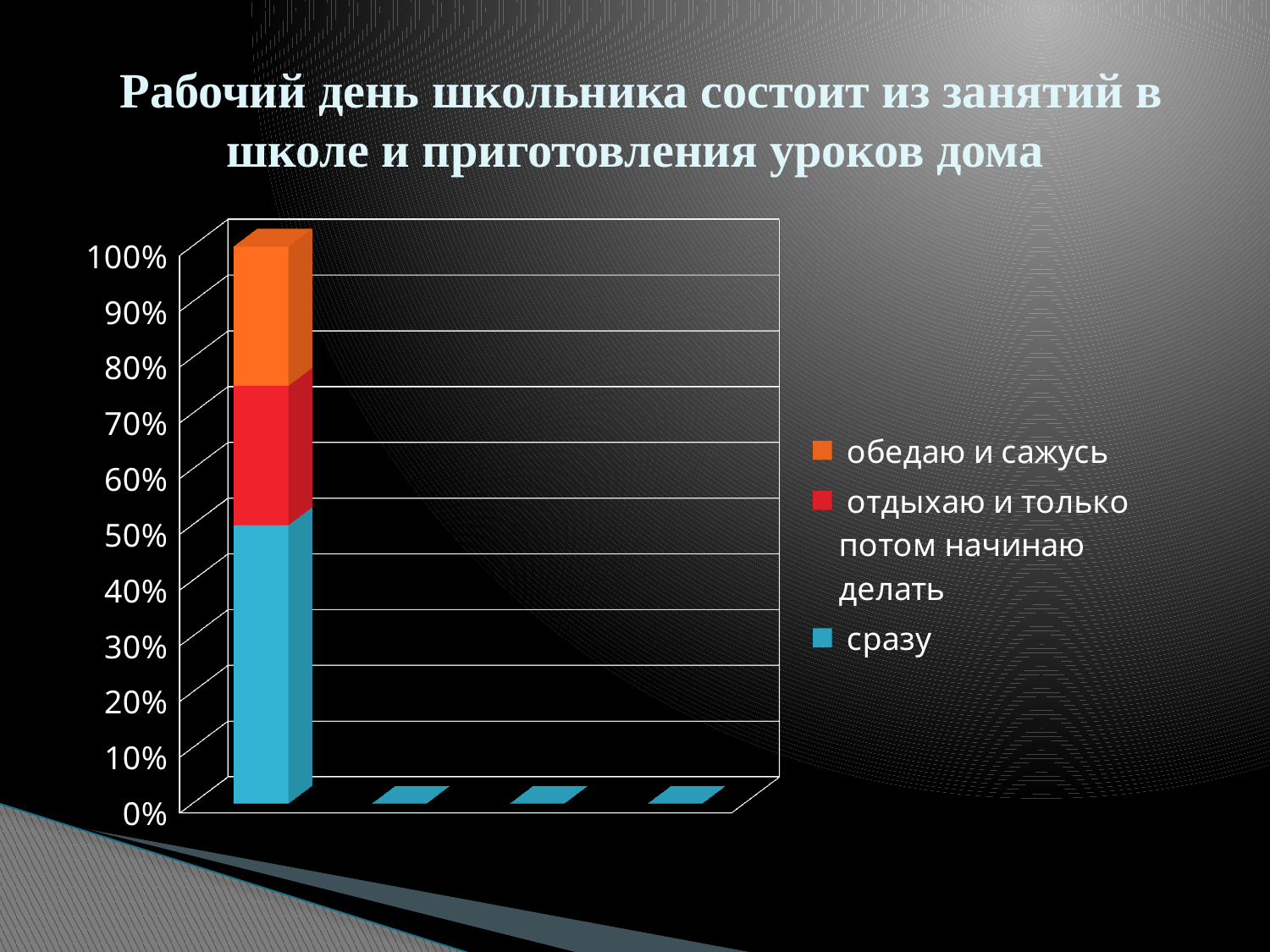
Which segment of the stacked bar is the largest? сразу Is the share of the "обедаю и сажусь" segment greater or less than 30%? less Which legend entry is shown in orange? обедаю и сажусь Which is larger in the stacked bar: the segment for "сразу" or the segment for "отдыхаю и только потом начинаю делать"? сразу How many series does the legend list? 3 What is the highest value shown on the vertical axis? 100% Which is larger in the stacked bar: the segment for "сразу" or the segment for "обедаю и сажусь"? сразу Is the share of the "сразу" segment greater or less than 40%? greater What kind of chart is shown on the slide? stacked bar chart Is the share of the "отдыхаю и только потом начинаю делать" segment greater or less than 30%? less Which legend entry is shown in blue? сразу